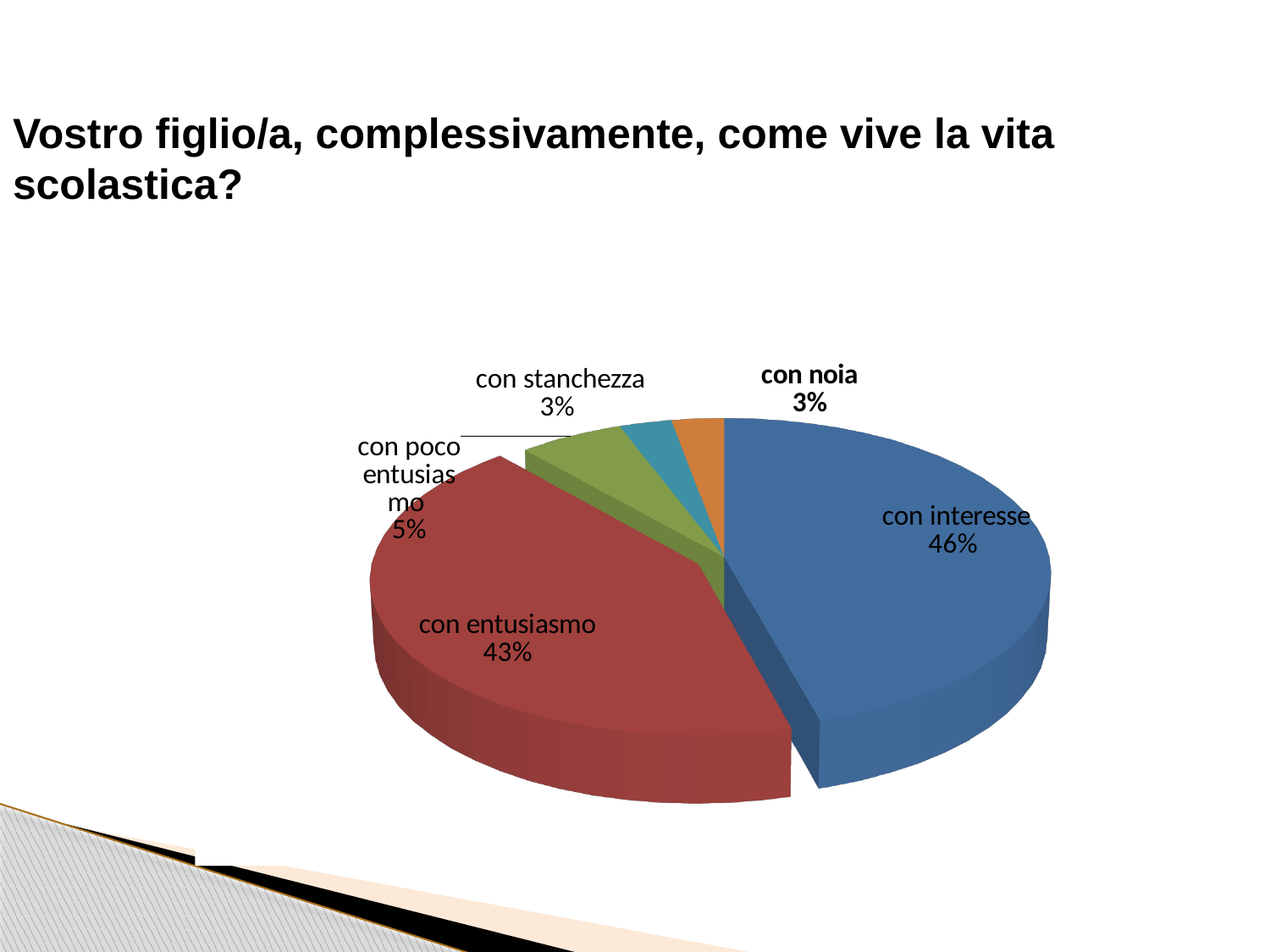
What percentage is shown for "con stanchezza"? 3% What share of the pie is labelled "con entusiasmo"? 43% What is the difference in percentage points between "con poco entusiasmo" and "con stanchezza"? 2 Which category has the largest slice of the pie? con interesse Which is larger, the slice for "con interesse" or the slice for "con entusiasmo"? con interesse What percentage is shown for "con poco entusiasmo"? 5% What kind of chart is shown on the slide? pie chart What share of the pie is labelled "con interesse"? 46% What percentage is shown for "con noia"? 3% How many slices does the pie chart have? 5 What is the difference in percentage points between "con interesse" and "con entusiasmo"? 3 What question is written as the title above the chart? Vostro figlio/a, complessivamente, come vive la vita scolastica?